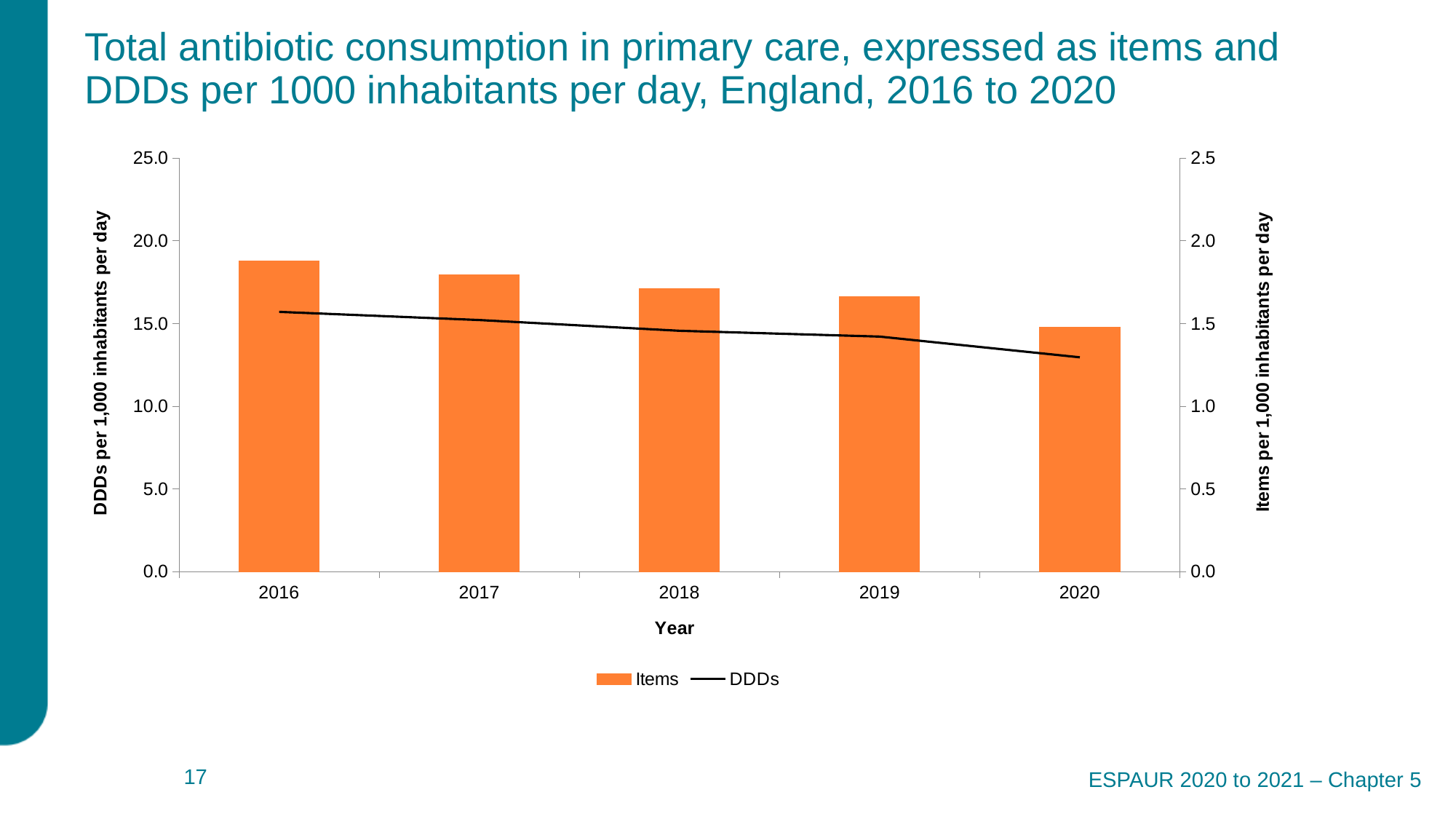
Do the Items bars rise or fall from 2016 to 2020? fall Is the Items bar taller for 2016 or for 2020? 2016 Is the Items bar for 2020 above or below the 2.0 mark on the right-hand axis? below What is the title of the x axis? Year Is the DDDs line for 2016 above or below the 10.0 mark on the left-hand axis? above Which year has the tallest Items bar? 2016 How many years are shown on the x axis? 5 How many series does the legend list? 2 Is the Items bar taller for 2017 or for 2019? 2017 Is the DDDs line for 2020 above or below the 15.0 mark on the left-hand axis? below Which year has the shortest Items bar? 2020